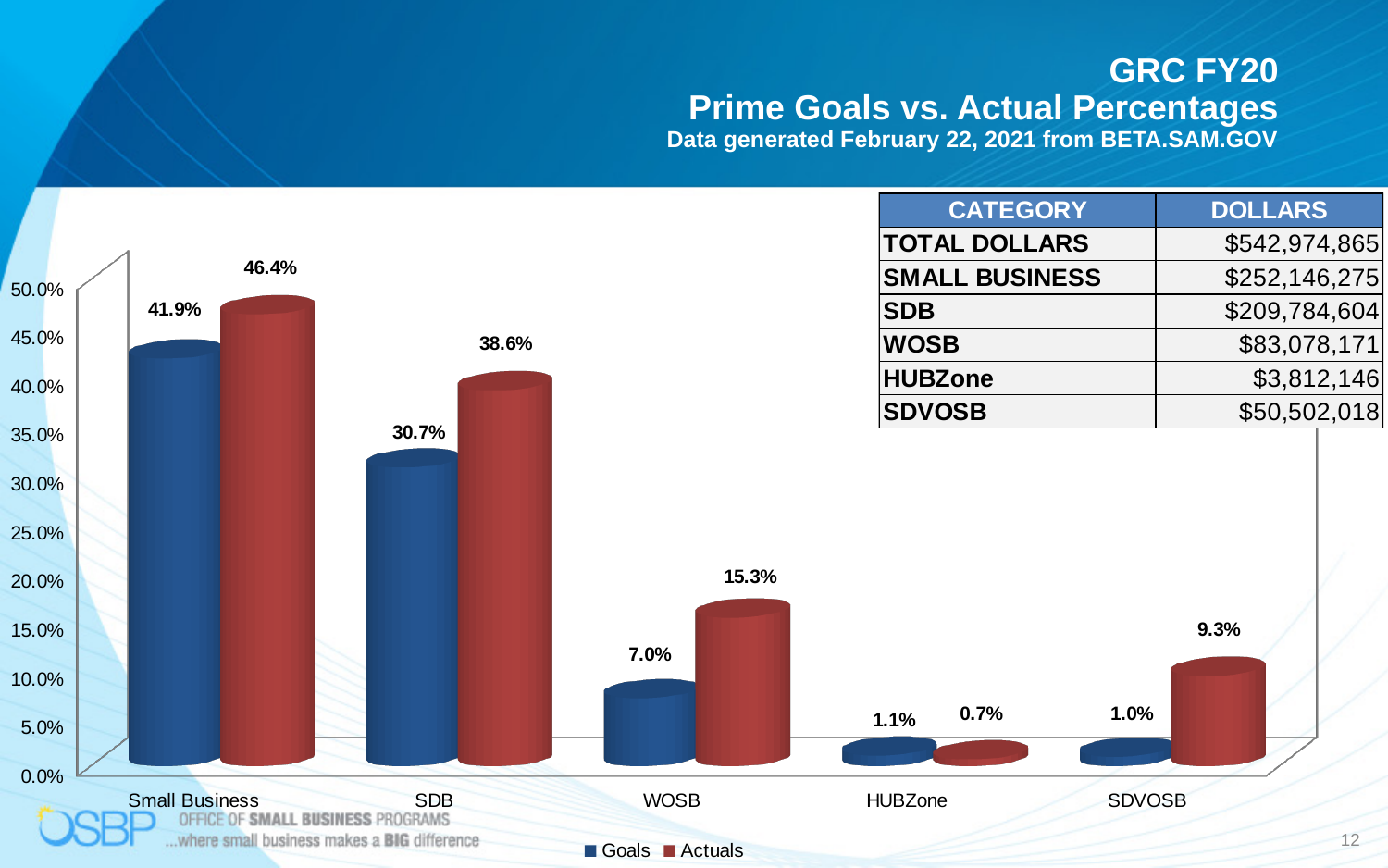
Which category has the highest Actuals value? Small Business How many series does the legend list? 2 What is the Actuals value for SDB? 38.6% What is the Goals value for HUBZone? 1.1% What is the Goals value for Small Business? 41.9% What kind of chart is shown on the slide? Bar chart Which colour represents the Actuals series in the legend? Red What is the difference between the Actuals and Goals values for SDVOSB? 8.3% Which is larger for HUBZone, the Goals value or the Actuals value? Goals How many categories are shown on the x axis? 5 Which category has the lowest Actuals value? HUBZone What is the Actuals value for WOSB? 15.3%